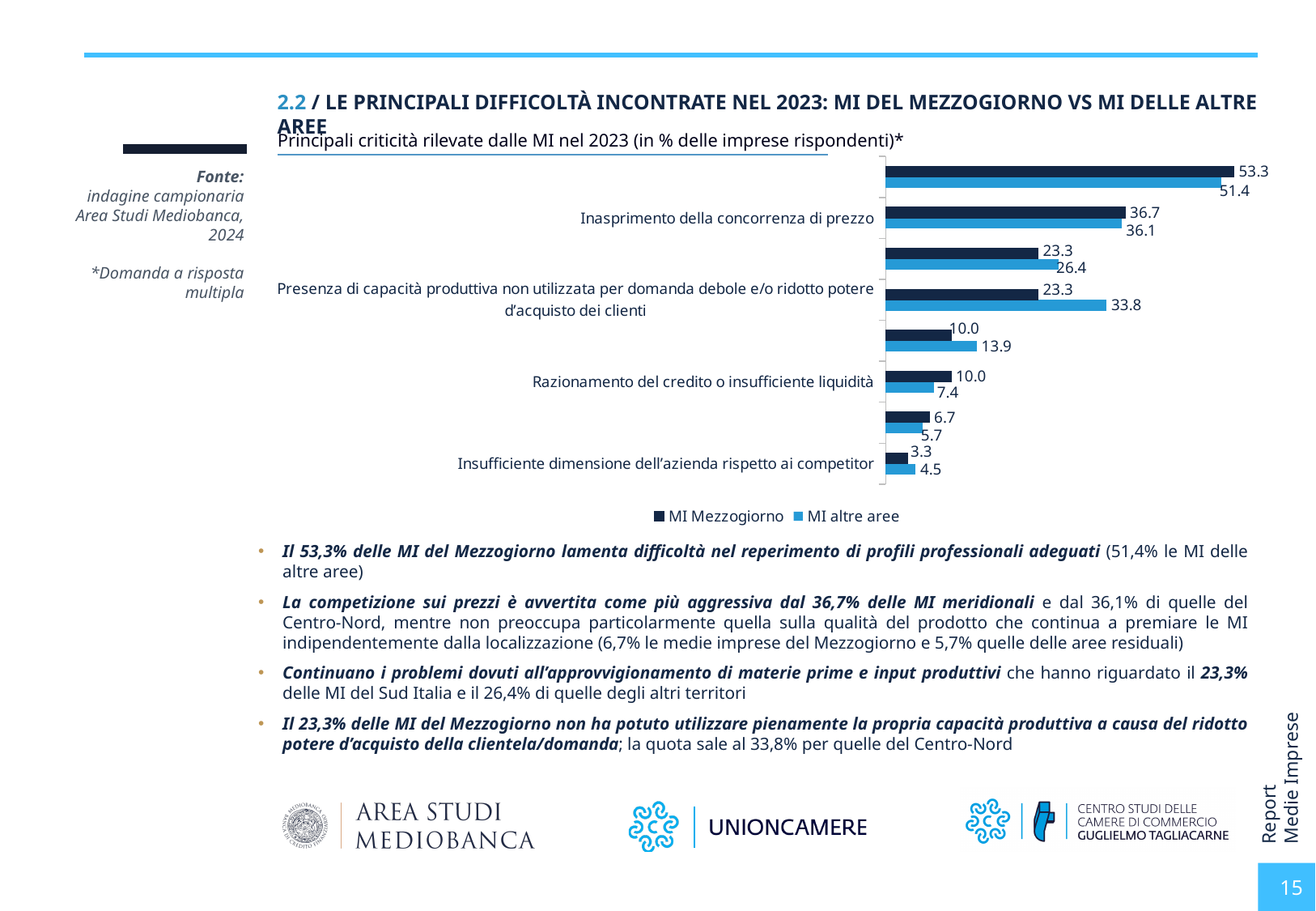
What is the difference between MI altre aree and MI Mezzogiorno for 'Presenza di capacità produttiva non utilizzata per domanda debole e/o ridotto potere d'acquisto dei clienti'? 10.5 What is the value for MI altre aree for 'Inasprimento della concorrenza di prezzo'? 36.1 For 'Razionamento del credito o insufficiente liquidità', which series has the larger value, MI Mezzogiorno or MI altre aree? MI Mezzogiorno How many series does the chart legend list? 2 What are the two series named in the chart legend? MI Mezzogiorno and MI altre aree For 'Insufficiente dimensione dell'azienda rispetto ai competitor', which series has the larger value, MI Mezzogiorno or MI altre aree? MI altre aree What is the value for MI altre aree for 'Presenza di capacità produttiva non utilizzata per domanda debole e/o ridotto potere d'acquisto dei clienti'? 33.8 What is the highest value shown for the MI Mezzogiorno series in the chart? 53.3 What type of chart is shown on the slide? Bar chart What is the value for MI Mezzogiorno for 'Inasprimento della concorrenza di prezzo'? 36.7 How many categories (pairs of bars) are plotted in the chart? 8 What is the value for MI Mezzogiorno for 'Razionamento del credito o insufficiente liquidità'? 10.0